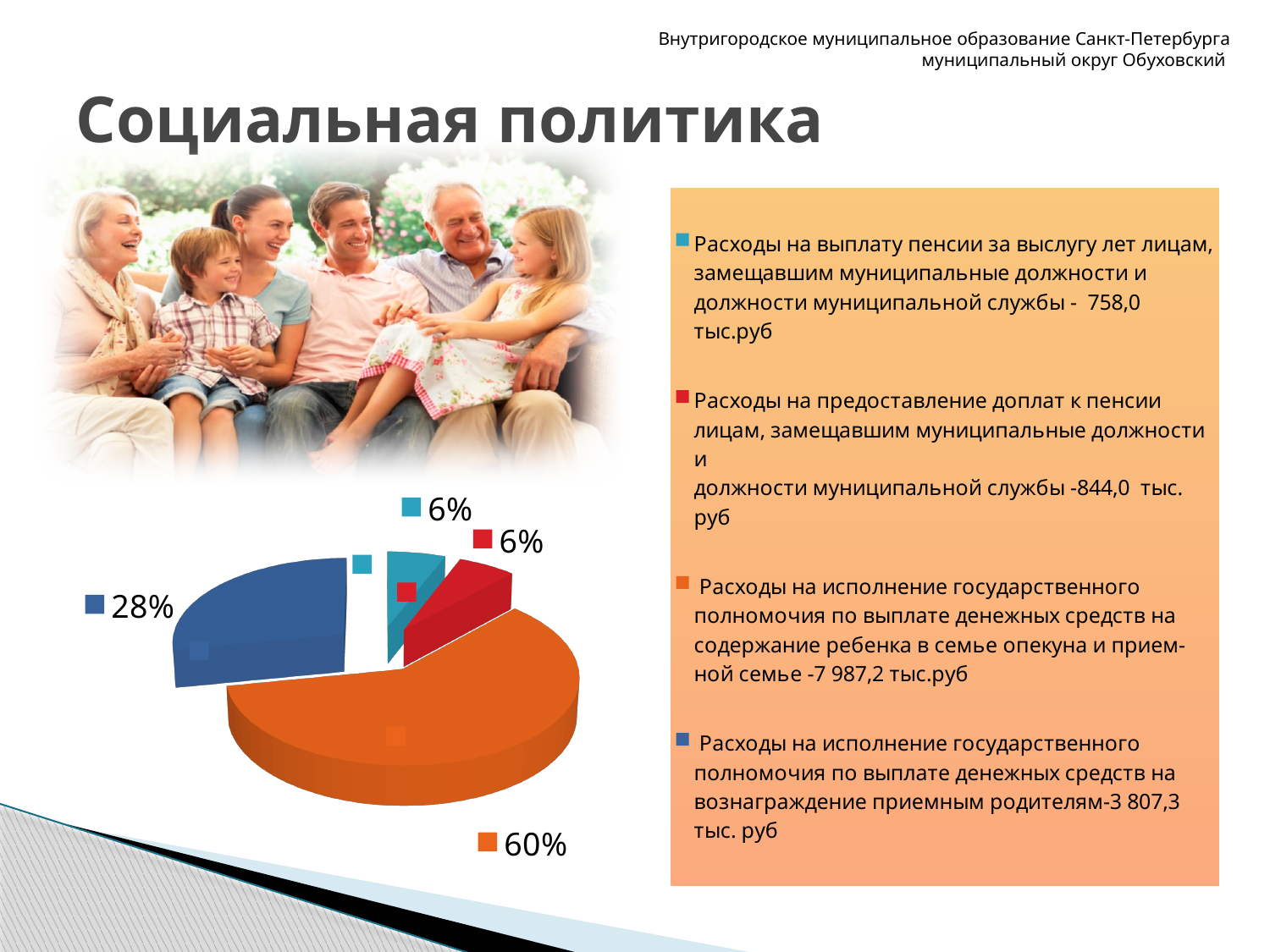
What share of the pie does the red slice represent? 6% What is the difference in percentage points between the orange slice and the blue slice? 32 What kind of chart is shown on the slide? pie chart Which slice of the pie chart is the largest? the orange slice (60%) What share of the pie does the orange slice represent? 60% What share of the pie does the blue slice represent? 28% Which is larger, the blue slice or the red slice? the blue slice Is the share of the orange slice greater or less than 50%? greater What colour is the slice representing 28% of the pie? blue How many slices does the pie chart have? 4 How many slices of the pie chart are labelled 6%? 2